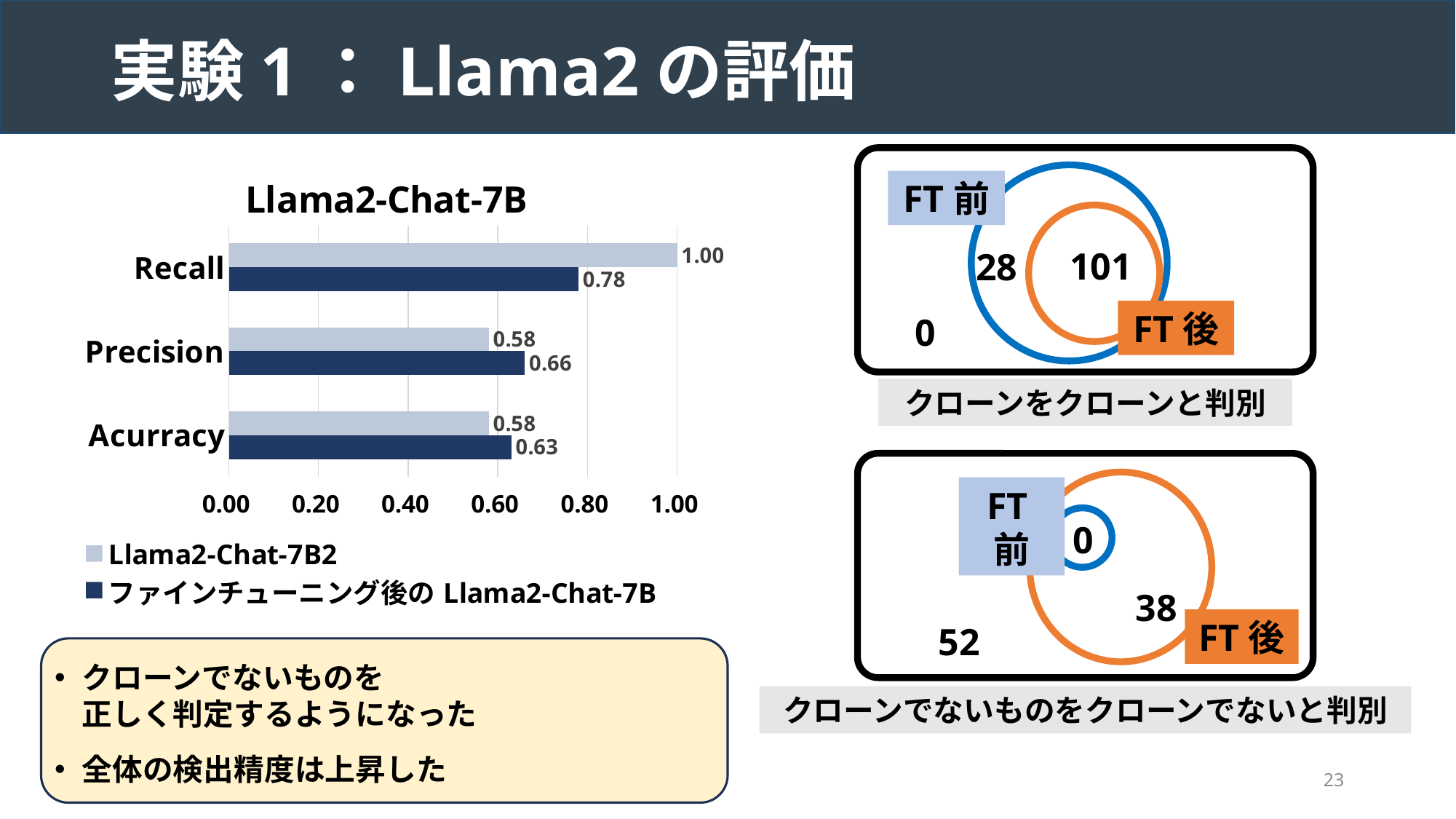
What is the Recall value for ファインチューニング後の Llama2-Chat-7B? 0.78 What is the Precision value for ファインチューニング後の Llama2-Chat-7B? 0.66 Which metric has the lowest value for ファインチューニング後の Llama2-Chat-7B? Acurracy What is the Acurracy value for Llama2-Chat-7B2? 0.58 Is the Acurracy value for ファインチューニング後の Llama2-Chat-7B greater or less than 0.60? greater What type of chart is used to show the Llama2-Chat-7B evaluation? Bar chart How many series does the legend of the Llama2-Chat-7B chart list? 2 What is the Recall value for Llama2-Chat-7B2 in the Llama2-Chat-7B chart? 1.00 What is the difference between the Recall values of Llama2-Chat-7B2 and ファインチューニング後の Llama2-Chat-7B? 0.22 How many metrics (categories) are shown in the Llama2-Chat-7B bar chart? 3 Which metric has the highest value for Llama2-Chat-7B2? Recall For Precision, which series has the larger value: Llama2-Chat-7B2 or ファインチューニング後の Llama2-Chat-7B? ファインチューニング後の Llama2-Chat-7B